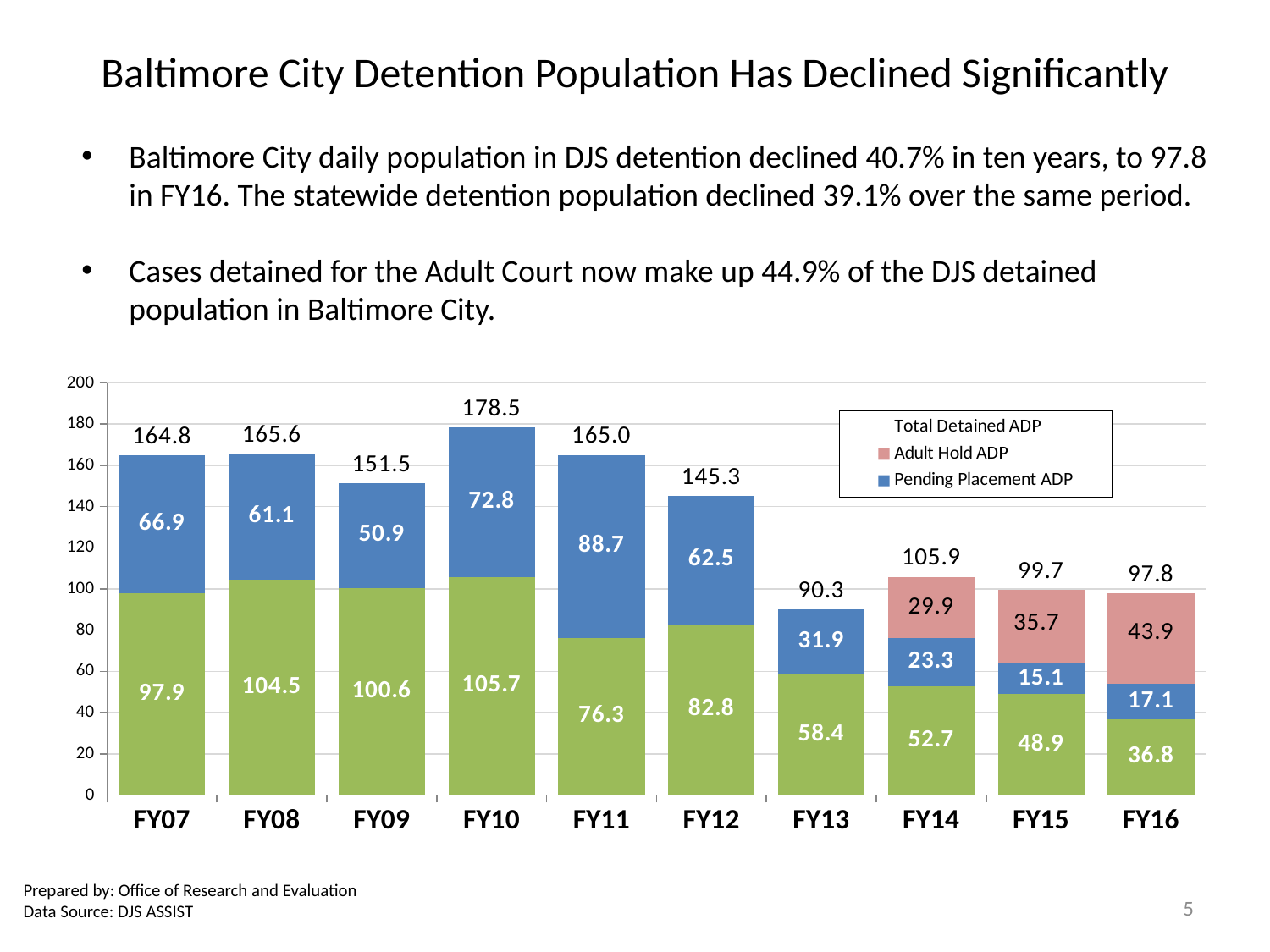
How many fiscal years are shown on the x axis? 10 What is the Pending Placement ADP value for FY11? 88.7 What is the difference between the total detained ADP in FY07 and in FY16? 67.0 What is the value of the bottom green segment for FY09? 100.6 Is the total detained ADP for FY14 greater or less than 100? greater Which is larger, the Pending Placement ADP in FY12 or in FY13? FY12 What is the Adult Hold ADP value for FY16? 43.9 What is the total detained ADP for FY10? 178.5 Which fiscal year has the lowest total detained ADP? FY13 Which fiscal year has the highest total detained ADP? FY10 What kind of chart is shown on the slide? Stacked bar chart Do the total detained ADP values rise or fall from FY10 to FY16? Fall